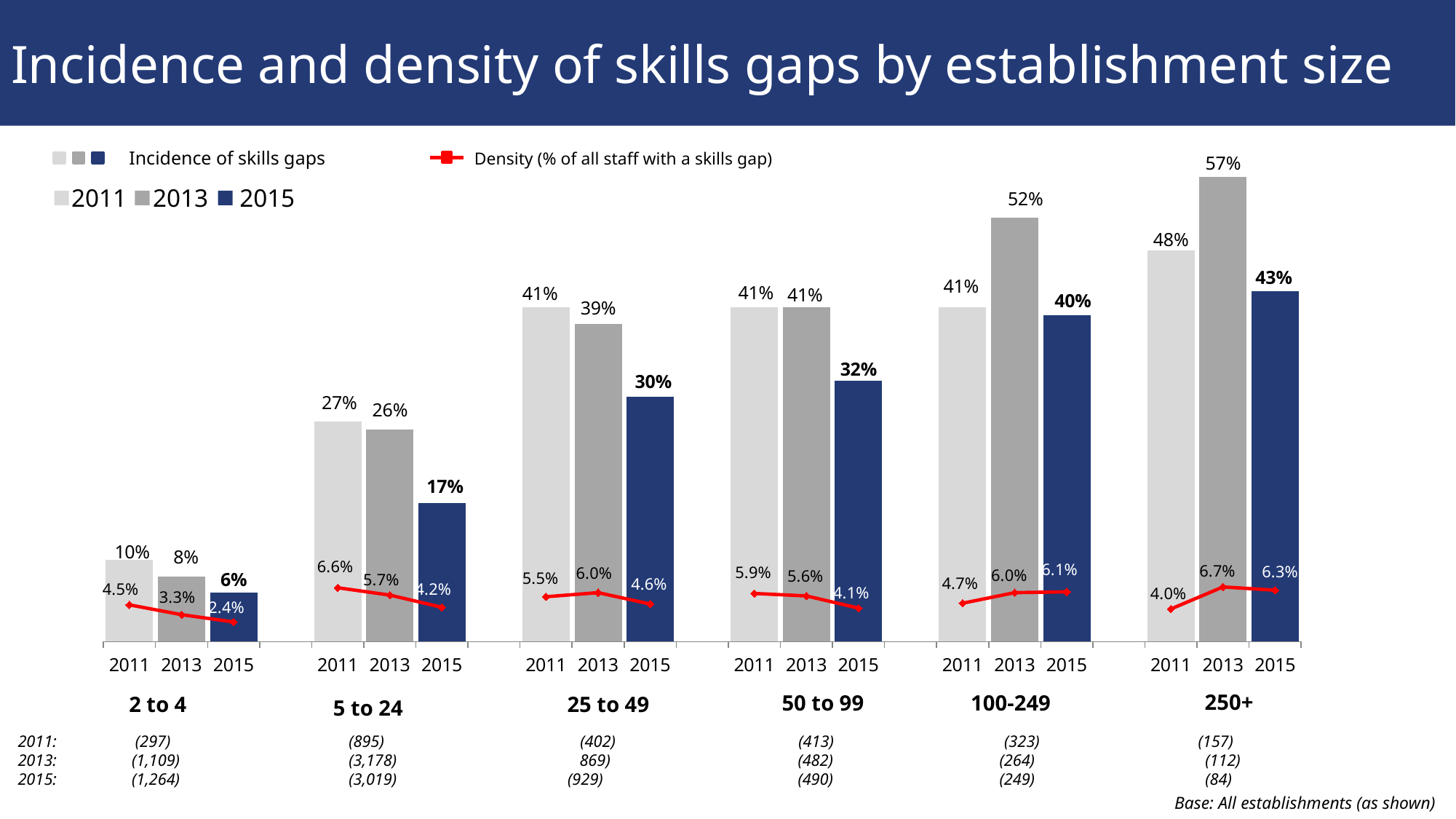
What kind of chart is used to show the incidence of skills gaps? Bar chart How many establishment size bands are shown on the chart? 6 How many years does the legend list for incidence of skills gaps? 3 What is the incidence of skills gaps for establishments with 5 to 24 staff in 2015? 17% Does the 2015 incidence of skills gaps rise or fall as establishment size increases from 2 to 4 up to 250+? Rise Is the 2015 incidence of skills gaps higher for establishments with 25 to 49 staff or 50 to 99 staff? 50 to 99 Which establishment size band has the highest incidence of skills gaps in 2015? 250+ What is the density of skills gaps for establishments with 2 to 4 staff in 2015? 2.4% What is the incidence of skills gaps for establishments with 250+ staff in 2013? 57% What is the difference between the 2013 and 2015 incidence of skills gaps for establishments with 100-249 staff? 12 percentage points What does the red line on the chart represent? Density (% of all staff with a skills gap) Which establishment size band has the lowest incidence of skills gaps in 2011? 2 to 4